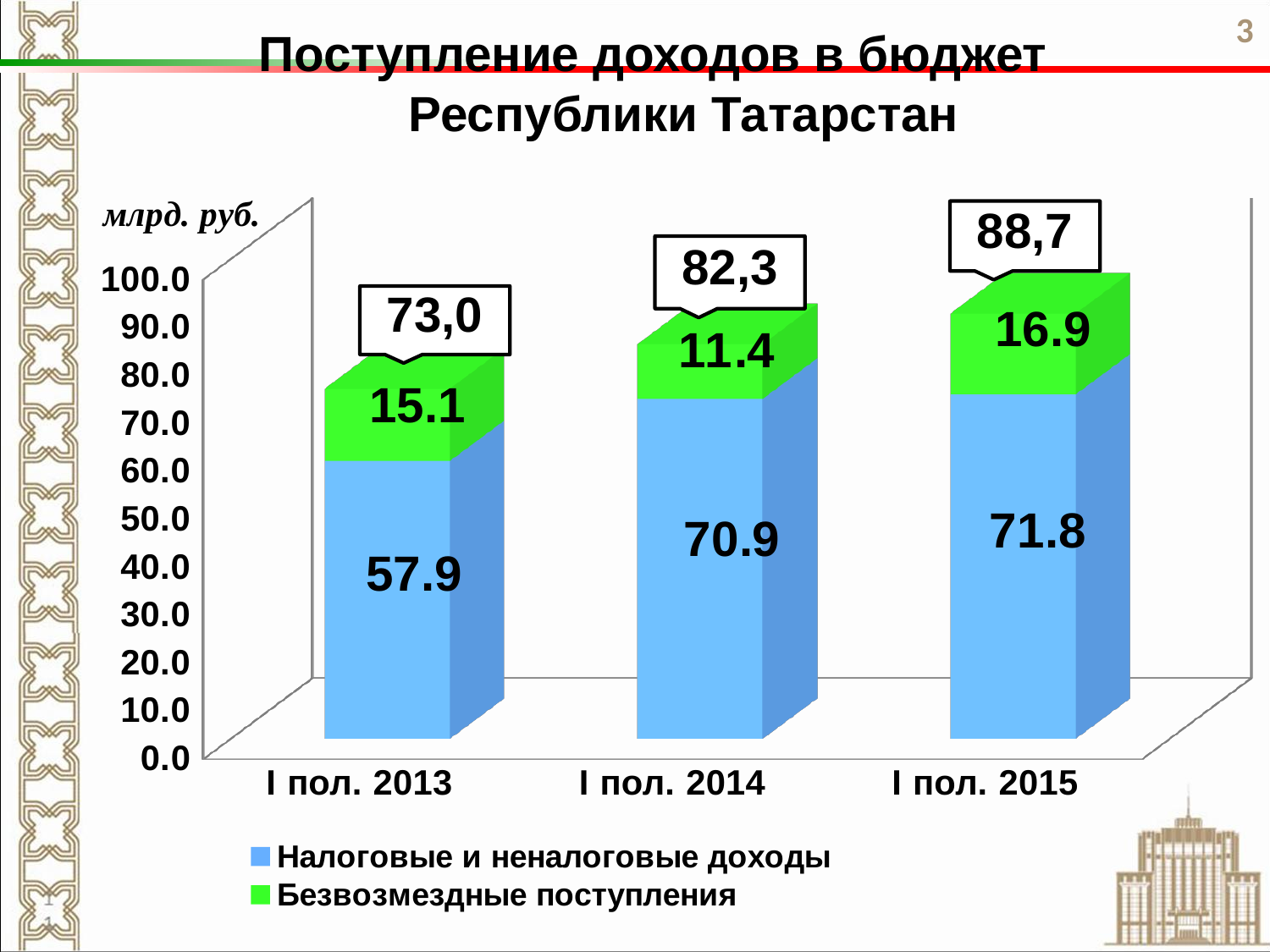
How many series does the legend list? 2 What unit is indicated for the values on the chart? млрд. руб. What is the value of Налоговые и неналоговые доходы for I пол. 2013? 57.9 What is the value of Безвозмездные поступления for I пол. 2015? 16.9 Which period has the highest value for Налоговые и неналоговые доходы? I пол. 2015 What is the difference between Налоговые и неналоговые доходы in I пол. 2014 and I пол. 2013? 13.0 How many periods are shown on the x axis? 3 What is the total shown above the bar for I пол. 2014? 82,3 Which is larger: Безвозмездные поступления in I пол. 2013 or in I пол. 2015? I пол. 2015 Do the total budget revenues rise or fall from I пол. 2013 to I пол. 2015? Rise What kind of chart is shown on the slide? Stacked bar chart Which period has the lowest value for Безвозмездные поступления? I пол. 2014